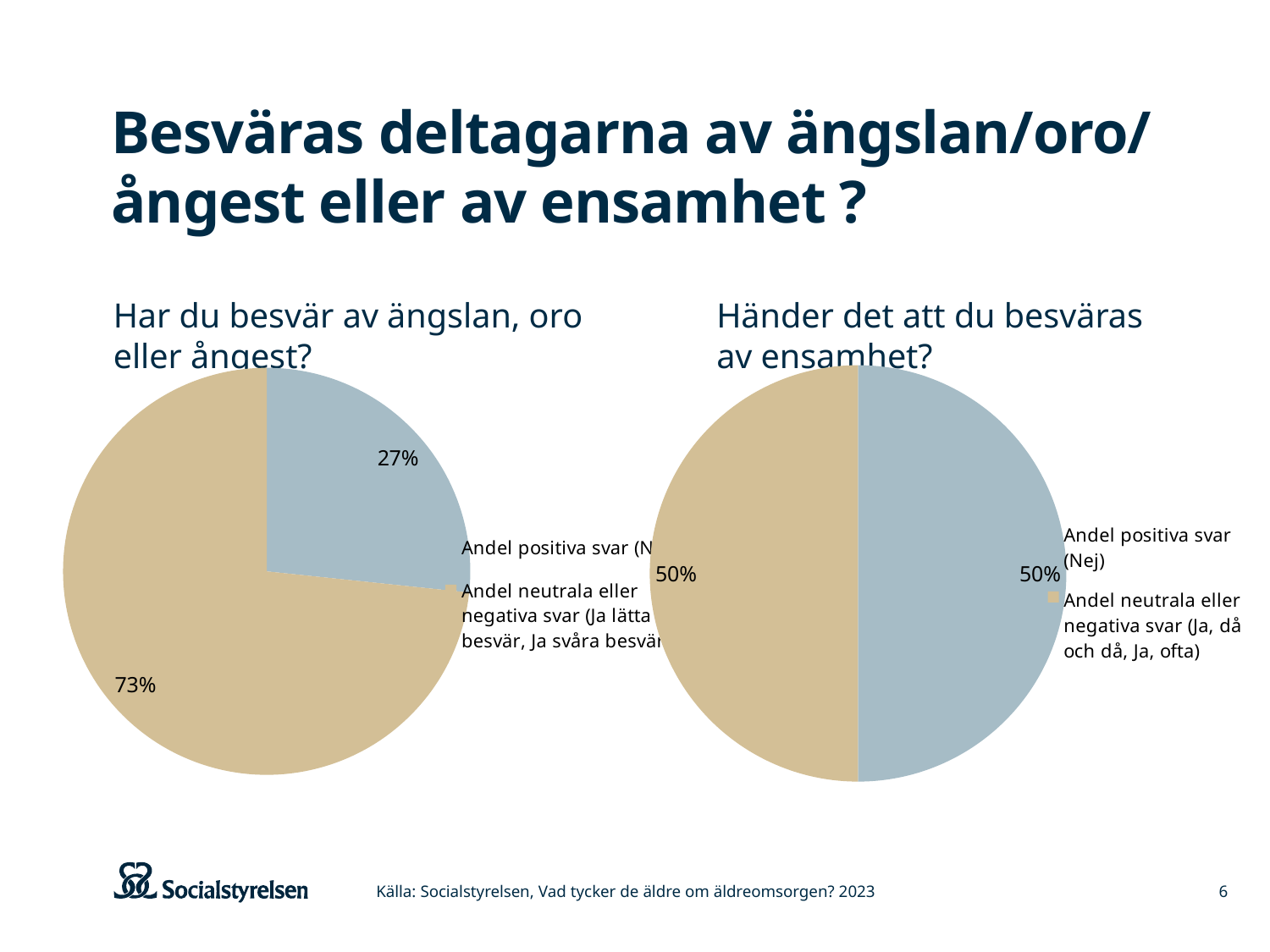
In the left chart 'Har du besvär av ängslan, oro eller ångest?', which slice is the smallest? Andel positiva svar (Nej) In the left chart 'Har du besvär av ängslan, oro eller ångest?', which slice is the largest? Andel neutrala eller negativa svar In the left chart 'Har du besvär av ängslan, oro eller ångest?', what share is shown for the 'Andel neutrala eller negativa svar' slice? 73% In the left chart 'Har du besvär av ängslan, oro eller ångest?', what is the difference in percentage points between the two slices? 46 How many pie charts are shown on the slide? 2 In the right chart 'Händer det att du besväras av ensamhet?', what share is shown for 'Andel neutrala eller negativa svar (Ja, då och då, Ja, ofta)'? 50% How many entries does the legend of the right chart 'Händer det att du besväras av ensamhet?' list? 2 How many slices does the left chart 'Har du besvär av ängslan, oro eller ångest?' have? 2 What kind of chart is used for 'Händer det att du besväras av ensamhet?' Pie chart In the left chart 'Har du besvär av ängslan, oro eller ångest?', is the 'Andel positiva svar (Nej)' slice larger or smaller than the 'Andel neutrala eller negativa svar' slice? Smaller In the left chart 'Har du besvär av ängslan, oro eller ångest?', what share of answers is labelled for the 'Andel positiva svar (Nej)' slice? 27%